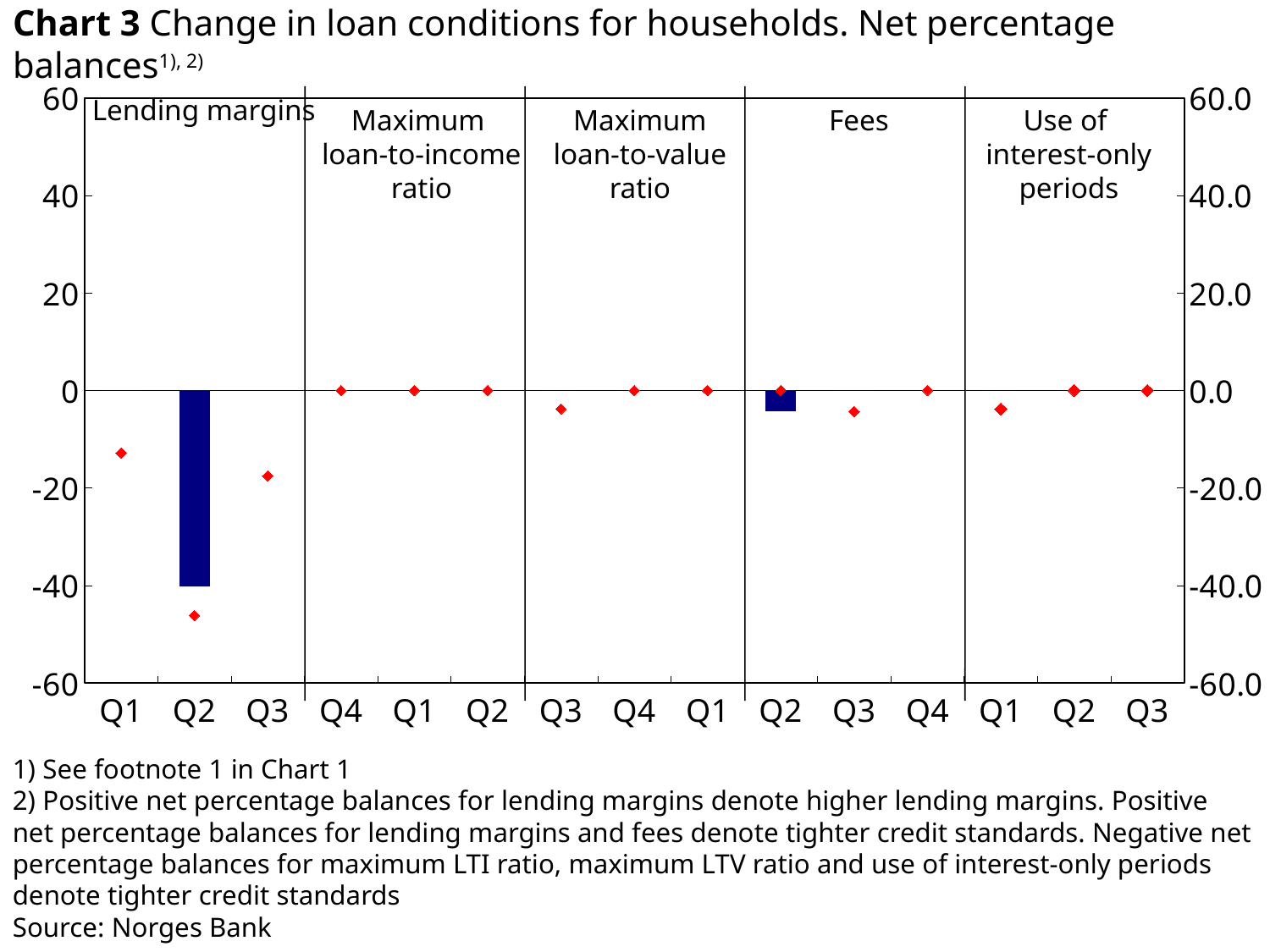
What is the source given for Chart 3? Norges Bank In the Lending margins panel, which quarter has the lowest red marker? Q2 Which panel contains the largest bar in Chart 3? Lending margins Is the Fees Q2 bar greater or less than -20? greater How many quarter labels are on the x axis of Chart 3? 15 What kind of chart is Chart 3? combination bar and line chart (bars with diamond markers) In the Lending margins panel, is the red marker for Q1 or Q3 higher? Q1 Is the red marker for Lending margins Q2 greater or less than -40? less Is the red marker for Lending margins Q1 greater or less than -20? greater How many loan-condition panels are shown in Chart 3? 5